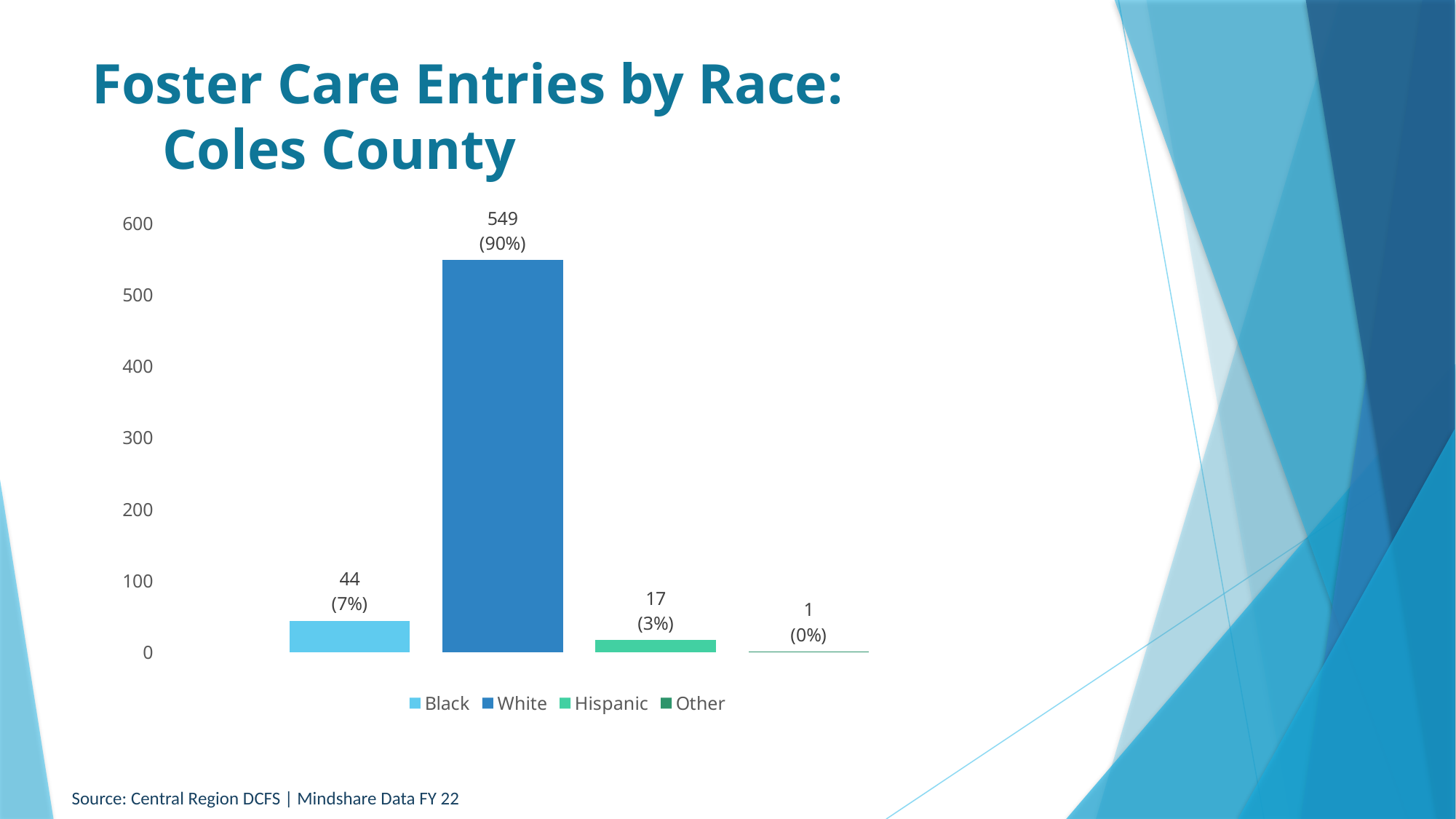
Which race category has the highest number of foster care entries? White How many foster care entries are shown for White? 549 Which race category has the lowest number of foster care entries? Other How many race categories are shown in the chart? 4 What is the source cited at the bottom of the slide? Central Region DCFS | Mindshare Data FY 22 Is the value for White greater or less than 500? greater What is the difference between the number of entries for White and Black? 505 What kind of chart is shown on the slide? Bar chart How many foster care entries are shown for Black? 44 Which has more foster care entries, Black or Hispanic? Black What percentage is shown for Hispanic? 3% How many foster care entries are shown for Other? 1